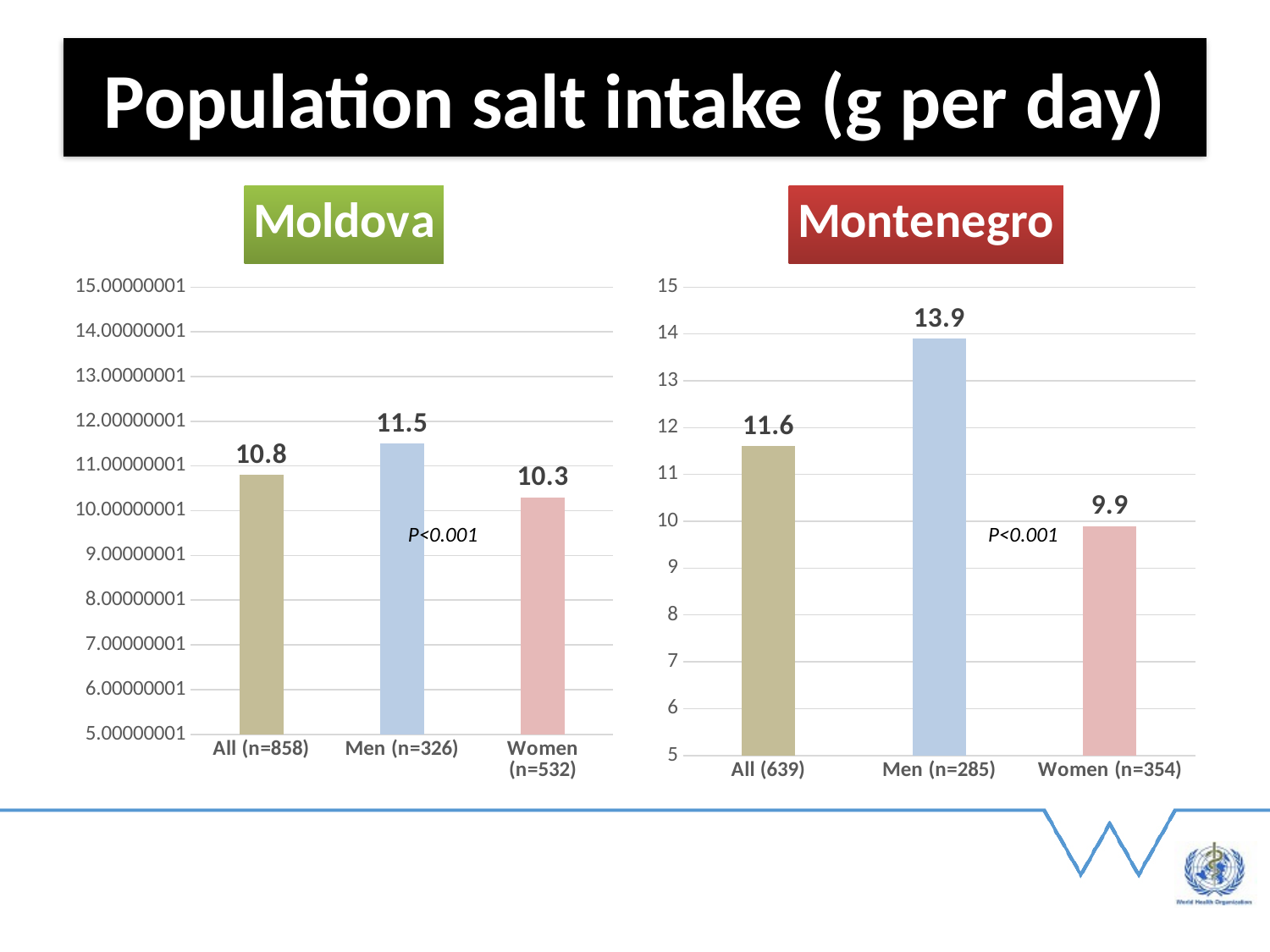
In the Moldova chart, which category has the lowest value? Women (n=532) In the Moldova chart, what is the salt intake value for Men (n=326)? 11.5 In the Moldova chart, what is the value for All (n=858)? 10.8 In the Moldova chart, what is the difference between the Men (n=326) and Women (n=532) values? 1.2 In the Montenegro chart, what is the difference between the Men (n=285) and Women (n=354) values? 4.0 In the Montenegro chart, is the value for Men (n=285) greater or less than 13? greater In the Montenegro chart, which category has the highest value? Men (n=285) In the Montenegro chart, what is the salt intake value for Women (n=354)? 9.9 What p-value is annotated on both charts? P<0.001 What type of chart is the Montenegro chart? Bar chart How many bars are shown in the Moldova chart? 3 Which is larger: the All value in the Moldova chart or the All value in the Montenegro chart? Montenegro (11.6)